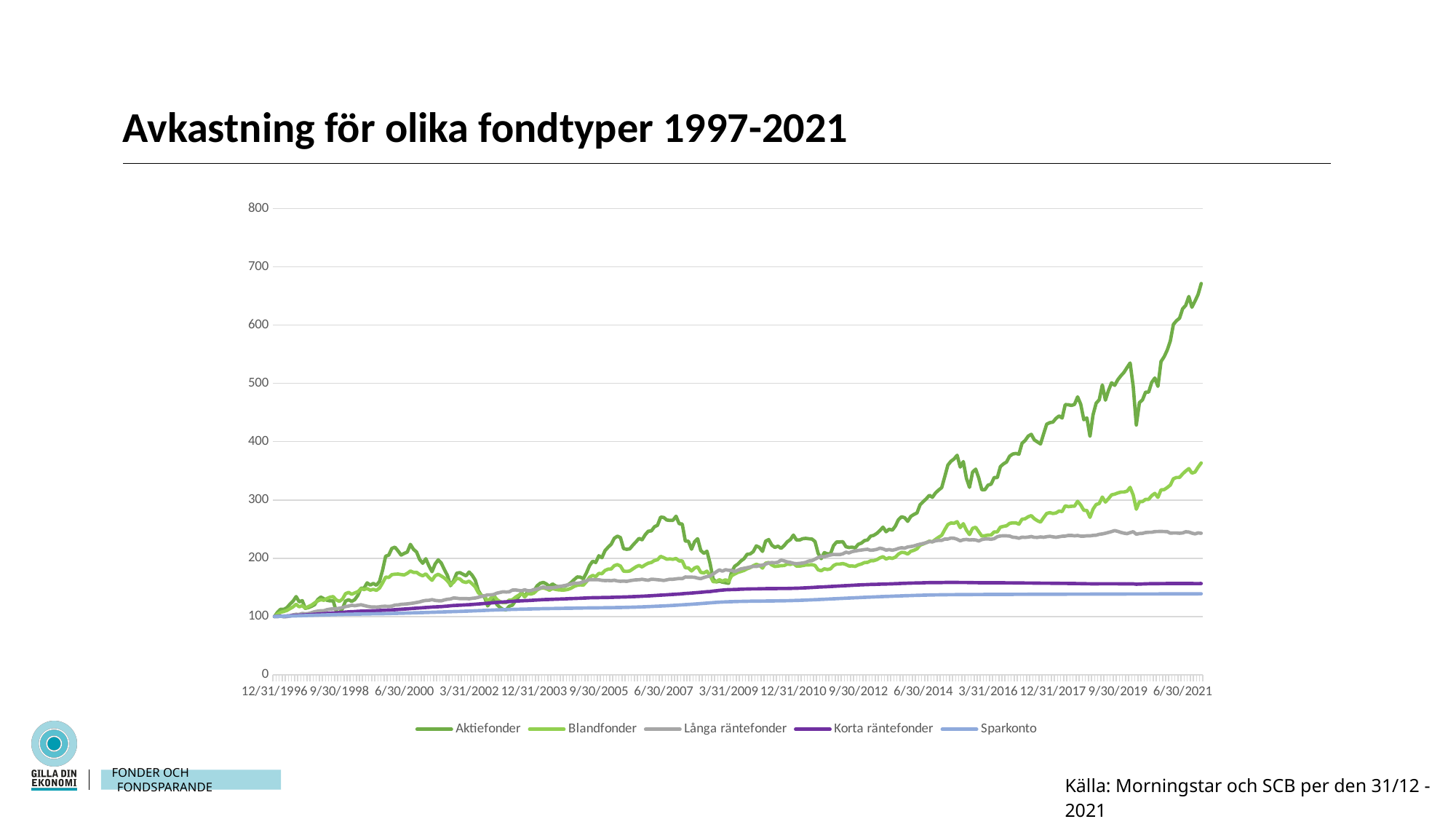
Is the value for Sparkonto at the end of the period greater or less than 200? less What is the highest value shown on the y axis? 800 Is the value for Blandfonder at the end of the period greater or less than 300? greater Is the value for Långa räntefonder at the end of the period greater or less than 300? less How many series does the legend list? 5 At the end of the period, which is higher: Blandfonder or Långa räntefonder? Blandfonder What kind of chart is shown on the slide? line chart Does the Sparkonto series rise or fall over the period from 12/31/1996 to 2021? rise What is the title of the chart? Avkastning för olika fondtyper 1997-2021 Which series has the highest value at the end of the period (6/30/2021 onward)? Aktiefonder Which series has the lowest value at the end of the period? Sparkonto